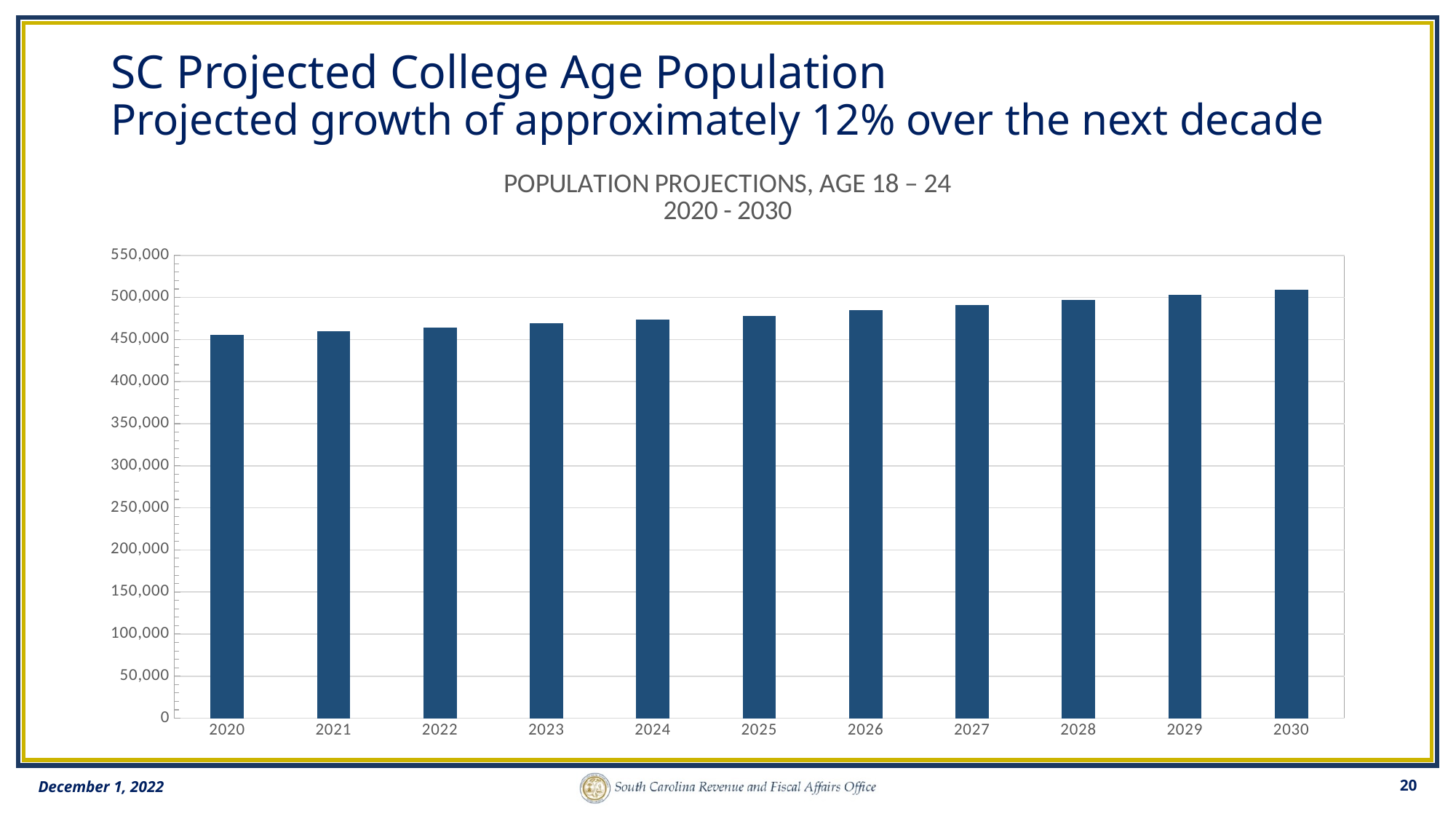
Is the value for 2020 greater or less than 500,000? less Is the value for 2030 greater or less than 450,000? greater Which is larger, the value for 2025 or the value for 2020? 2025 What kind of chart is shown on the slide? Bar chart What is the highest value shown on the vertical axis? 550,000 What is the title of the chart? POPULATION PROJECTIONS, AGE 18 – 24 2020 - 2030 How many years (bars) are plotted in the chart? 11 Do the values rise or fall from 2020 to 2030? Rise Which year has the highest projected population in the chart? 2030 Which is larger, the value for 2020 or the value for 2030? 2030 Is the value for 2027 greater or less than 450,000? greater Which year has the lowest projected population in the chart? 2020